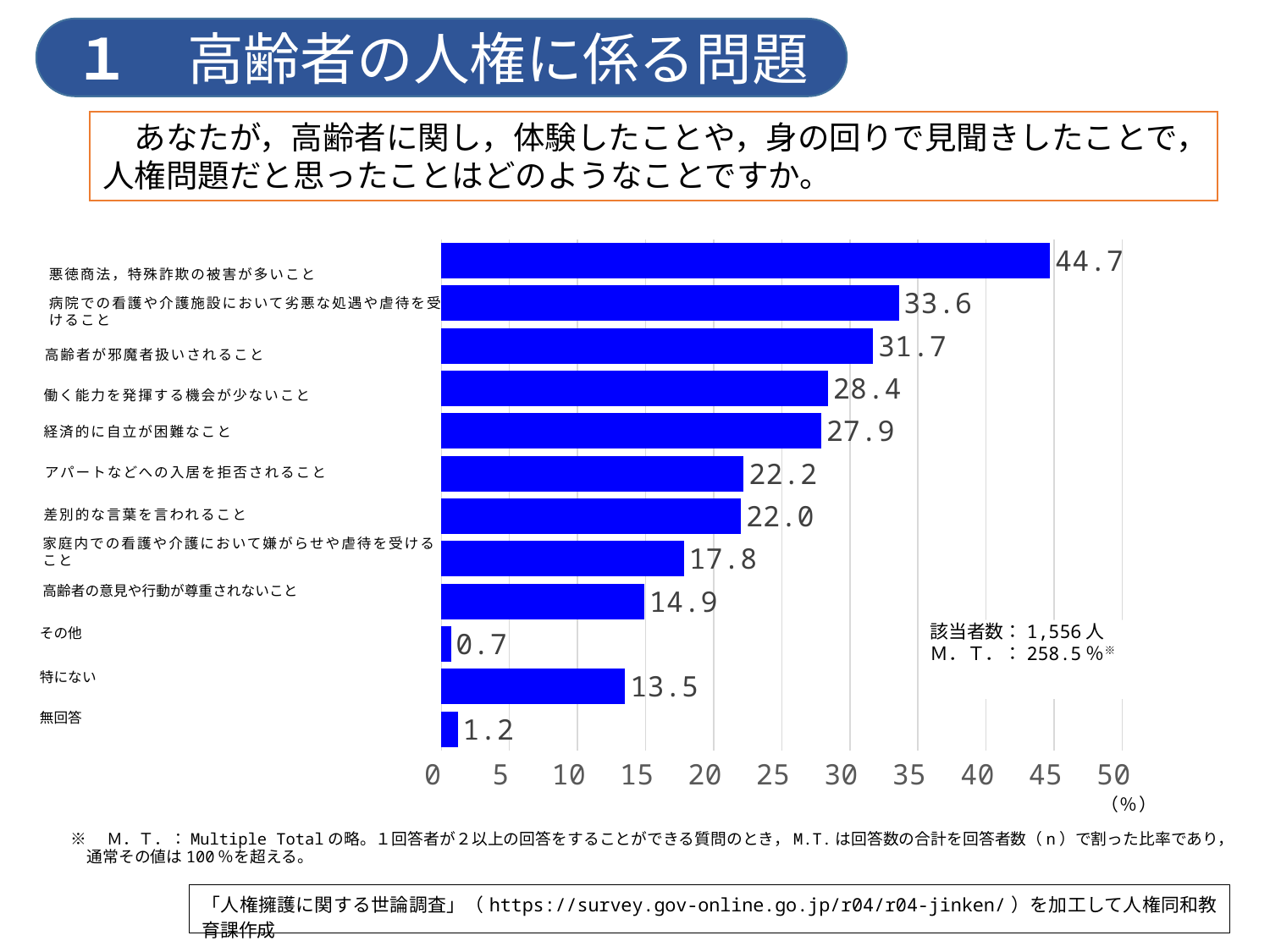
What is the difference between the values for 悪徳商法，特殊詐欺の被害が多いこと and 病院での看護や介護施設において劣悪な処遇や虐待を受けること? 11.1 What value is shown for 無回答? 1.2 Which is larger, the value for 働く能力を発揮する機会が少ないこと or the value for 高齢者の意見や行動が尊重されないこと? 働く能力を発揮する機会が少ないこと What value is shown for 悪徳商法，特殊詐欺の被害が多いこと? 44.7 How many categories are shown in the chart? 12 Which category has the highest value? 悪徳商法，特殊詐欺の被害が多いこと What value is shown for 高齢者が邪魔者扱いされること? 31.7 What kind of chart is shown on the slide? bar chart Which category has the lowest value? その他 Is the value for 経済的に自立が困難なこと greater or less than 25? greater What is the 該当者数 (number of respondents) noted on the chart? 1,556人 What value is shown for 特にない? 13.5